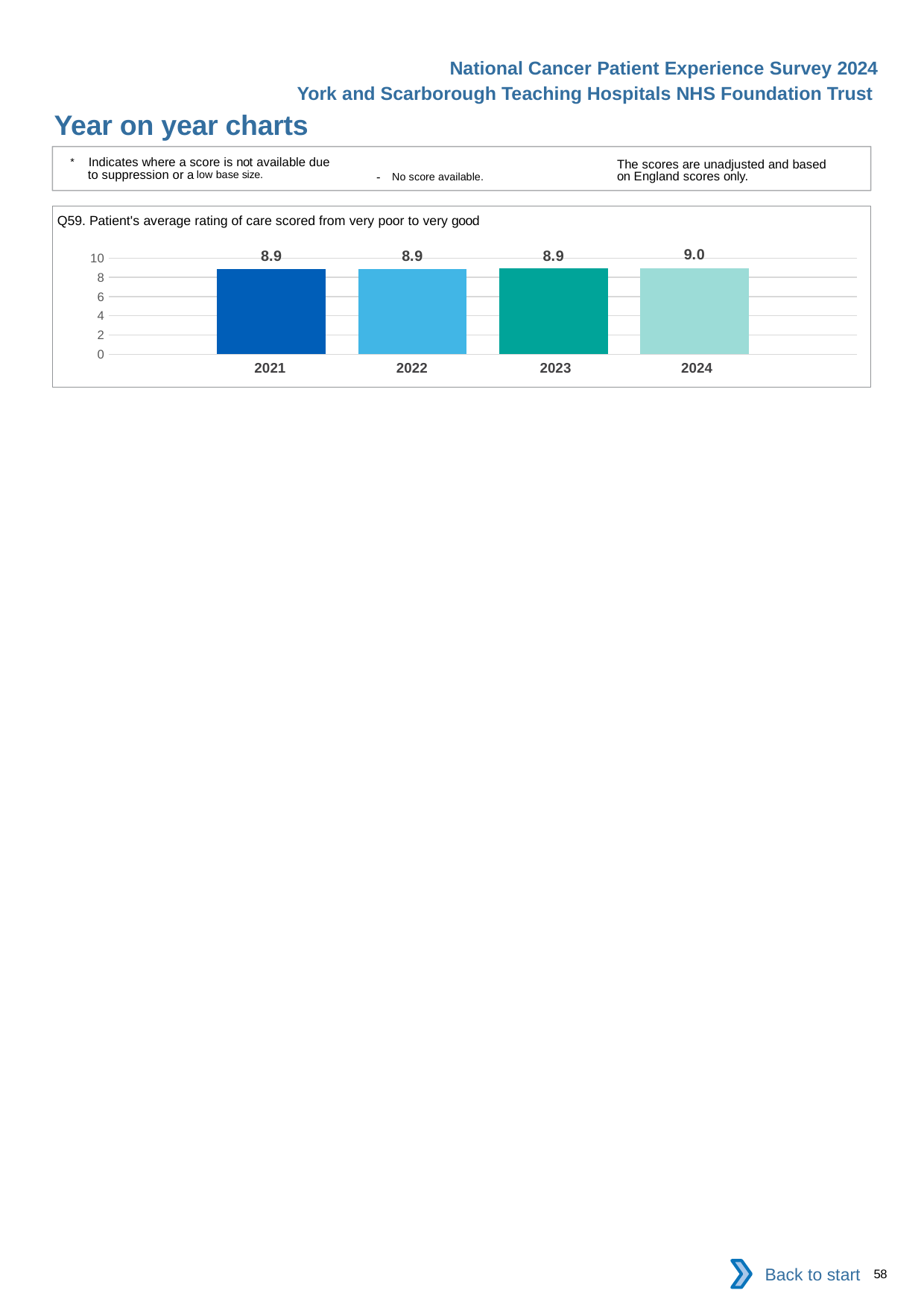
What is the value for 2021 in the Q59 chart? 8.9 What is the difference between the 2024 and 2021 values in the Q59 chart? 0.1 How many years are shown in the Q59 chart? 4 Do the values in the Q59 chart rise or fall from 2021 to 2024? rise What kind of chart is shown for Q59? bar chart What is the maximum value shown on the y axis of the Q59 chart? 10 What is the title of the chart on the slide? Q59. Patient's average rating of care scored from very poor to very good Which year has the highest value in the Q59 chart? 2024 What is the value for 2023 in the Q59 chart? 8.9 Is the value for 2022 in the Q59 chart greater or less than 6? greater What is the value for 2024 in the Q59 chart? 9.0